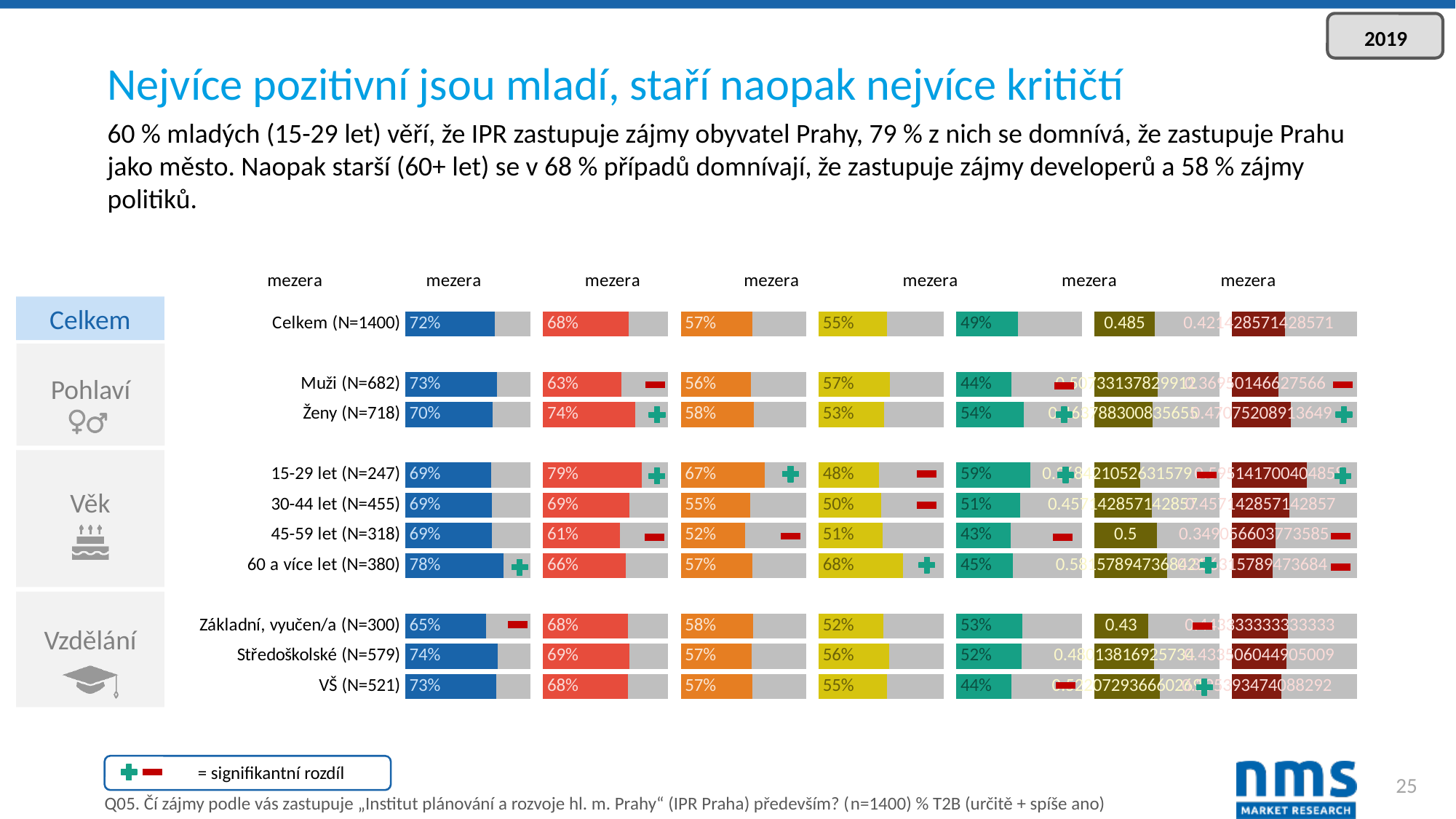
In the second (red) column of bars, which row has the highest value? 15-29 let (N=247) In the fifth (teal) column of bars, what is the value for 45-59 let (N=318)? 43% How many rows (respondent groups) are plotted in the chart? 10 In the first (blue) column of bars, what is the value for Celkem (N=1400)? 72% In the second (red) column of bars, what is the difference between the values for Ženy (N=718) and Muži (N=682)? 11 percentage points In the second (red) column of bars, what is the value for 15-29 let (N=247)? 79% What kind of chart is shown on the slide? Bar chart In the first (blue) column of bars, which row has the highest value? 60 a více let (N=380) In the first (blue) column of bars, what is the difference between the values for Celkem (N=1400) and Základní, vyučen/a (N=300)? 7 percentage points In the first (blue) column of bars, which row has the lowest value? Základní, vyučen/a (N=300) In the fourth (yellow) column of bars, which is larger: the value for 60 a více let (N=380) or for 15-29 let (N=247)? 60 a více let (N=380) In the third (orange) column of bars, what is the value for 15-29 let (N=247)? 67%